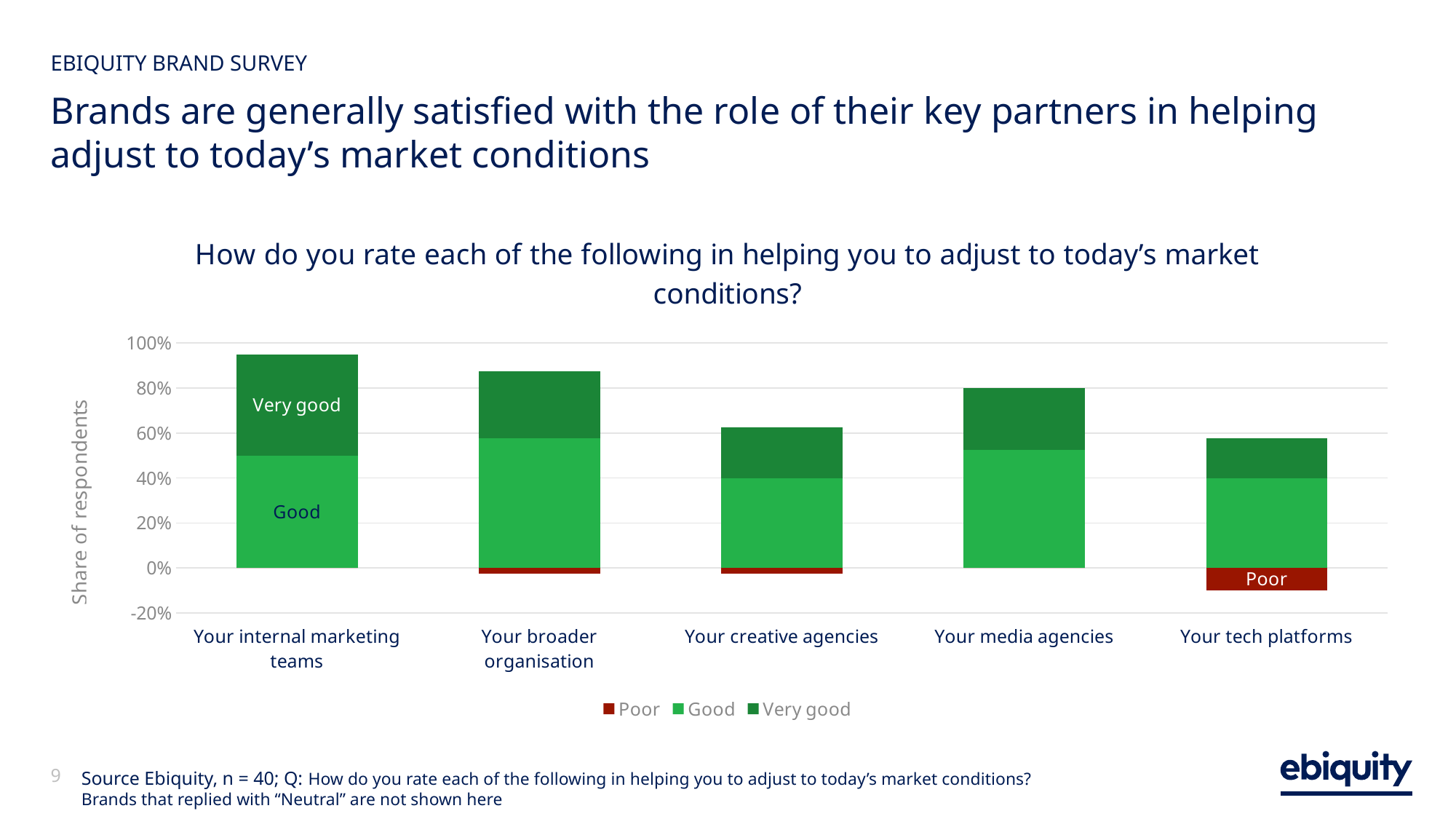
How many series does the chart legend list? 3 Which category has the shortest stacked bar above 0% (the smallest combined Good and Very good share)? Your tech platforms Is the combined Good and Very good share for Your internal marketing teams greater or less than 80%? greater Which category has the largest Poor share? Your tech platforms Which is larger: the Very good share for Your internal marketing teams or the Very good share for Your creative agencies? Your internal marketing teams Which category has the tallest stacked bar above 0% (the largest combined Good and Very good share)? Your internal marketing teams Is the combined Good and Very good share for Your tech platforms greater or less than 80%? less How many categories are shown on the x axis of the chart? 5 Is the combined Good and Very good share for Your broader organisation greater or less than 80%? greater What is the title of the chart's vertical axis? Share of respondents Which is larger: the Good share for Your broader organisation or the Good share for Your creative agencies? Your broader organisation What kind of chart is shown on the slide? Stacked bar chart